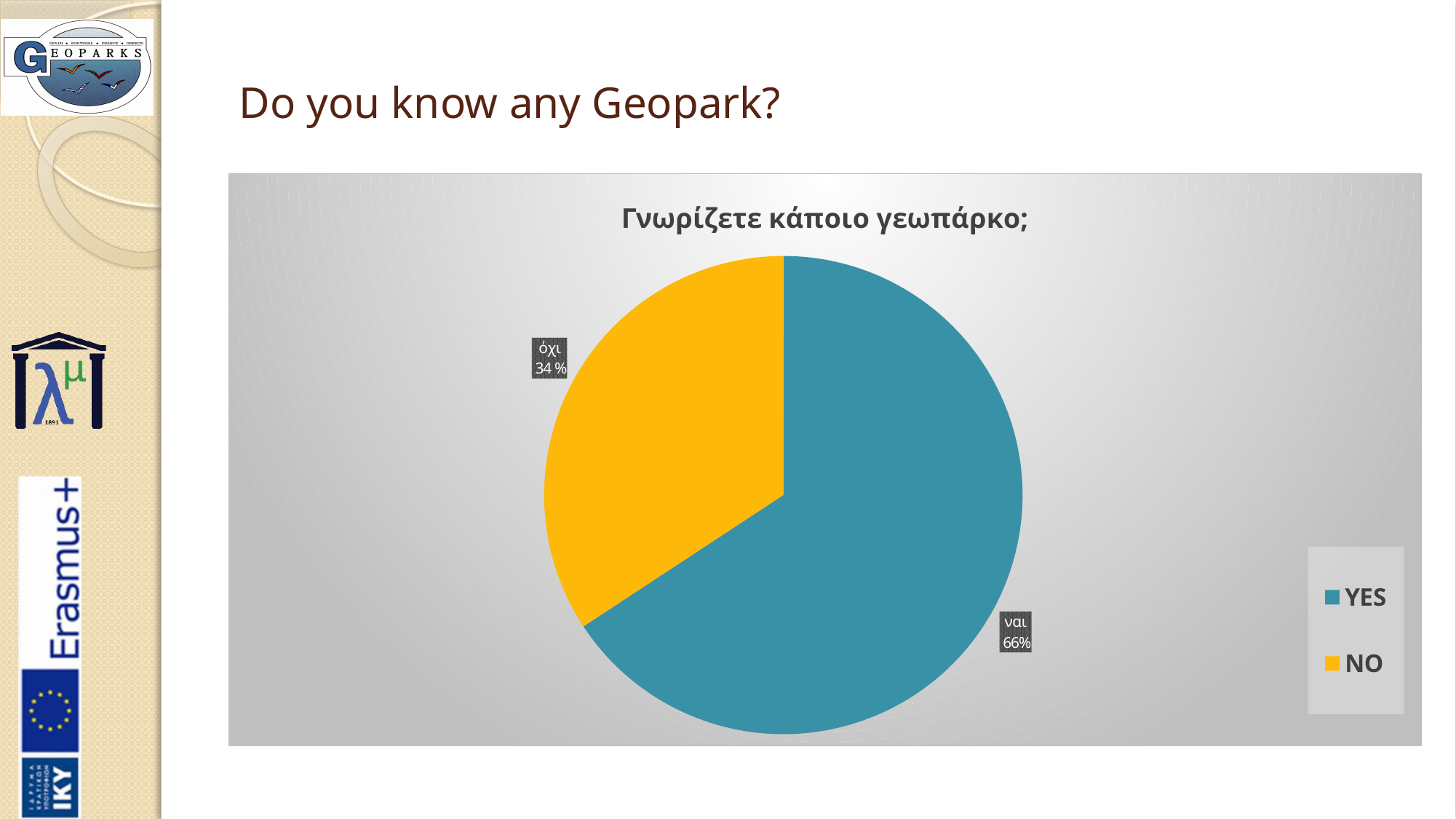
What percentage of respondents answered NO (όχι)? 34 % What percentage of respondents answered YES (ναι)? 66% What is the difference in percentage points between the YES and NO slices? 32 What kind of chart is shown on the slide? pie chart What is the title of the chart? Γνωρίζετε κάποιο γεωπάρκο; How many entries does the legend list? 2 How many slices does the pie chart have? 2 Which answer has the smallest share of the pie? NO What colour is the YES slice? teal blue Which answer has the largest share of the pie? YES Is the share for YES greater or less than 50%? greater Which slice is larger, YES or NO? YES